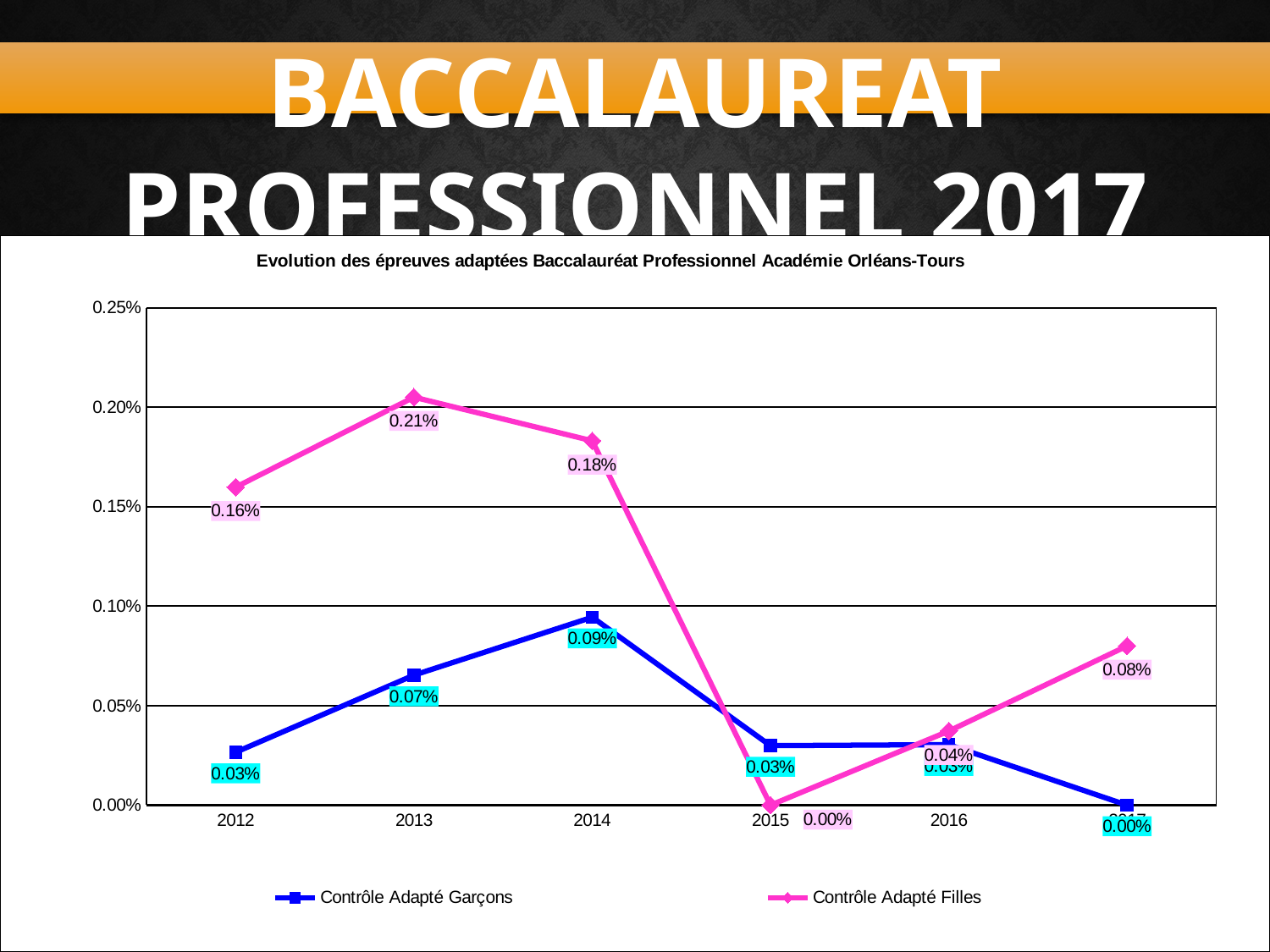
Is the value for Contrôle Adapté Filles in 2012 greater or less than 0.15%? greater What is the value for Contrôle Adapté Filles in 2015? 0.00% How many years are plotted on the x axis? 6 In which year is the Contrôle Adapté Filles value lowest? 2015 Does the Contrôle Adapté Filles line rise or fall from 2014 to 2015? fall What kind of chart is shown on the slide? line chart What is the difference between the Contrôle Adapté Filles values in 2013 and 2012? 0.05% What is the value for Contrôle Adapté Filles in 2013? 0.21% What is the value for Contrôle Adapté Garçons in 2014? 0.09% In 2014, which series has the larger value, Contrôle Adapté Garçons or Contrôle Adapté Filles? Contrôle Adapté Filles How many series does the legend list? 2 In which year is the Contrôle Adapté Filles value highest? 2013